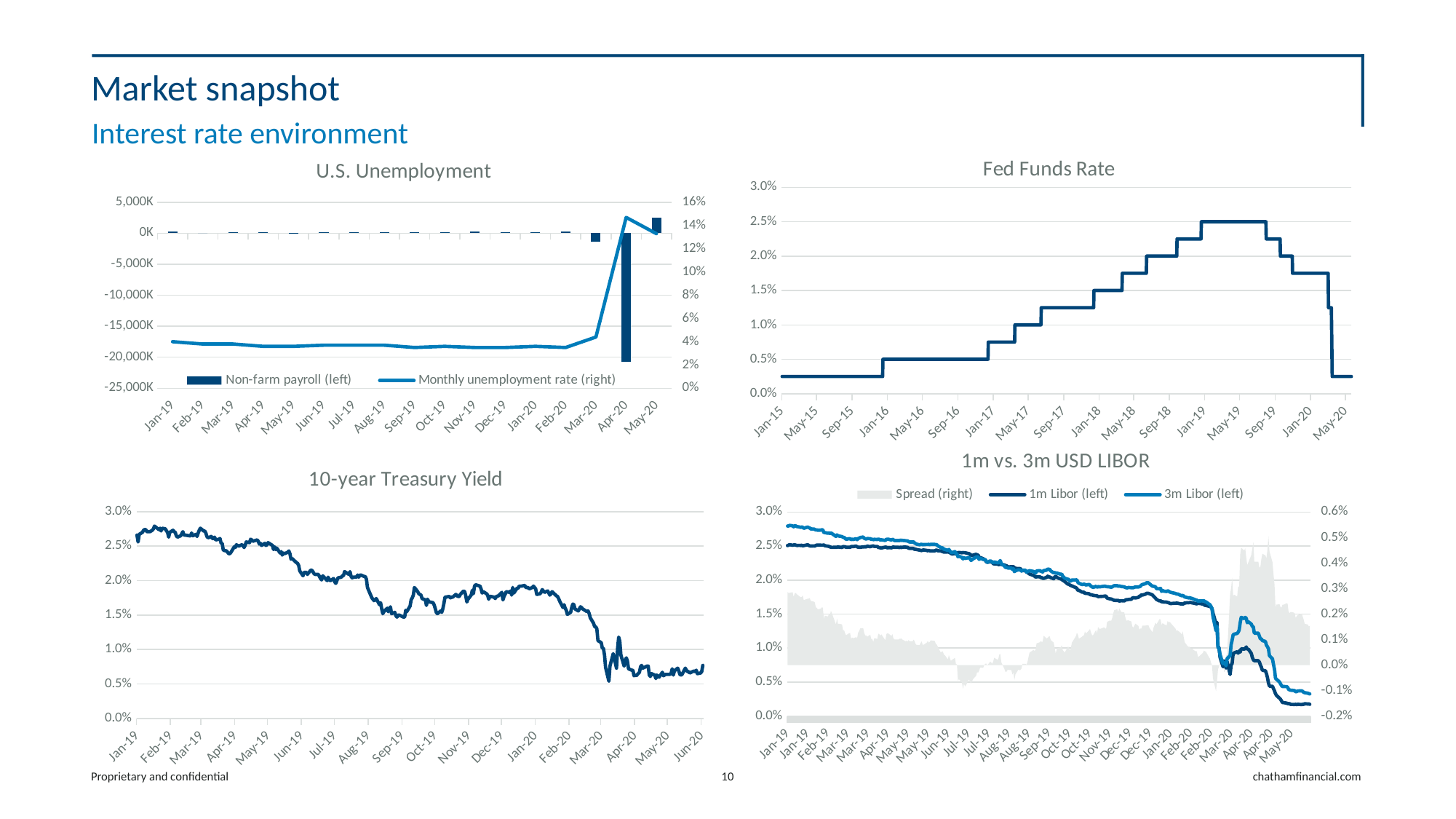
In the Fed Funds Rate chart, does the rate rise or fall from Jan-15 to May-19? rises In the U.S. Unemployment chart, is the monthly unemployment rate for Apr-20 greater or less than 12%? greater In the 10-year Treasury Yield chart, does the yield rise or fall overall from Jan-19 to Jun-20? falls In the Fed Funds Rate chart, is the value at May-20 greater or less than 0.5%? less In the 1m vs. 3m USD LIBOR chart, how many series does the legend list? 3 In the Fed Funds Rate chart, is the value at May-19 greater or less than 2.0%? greater In the U.S. Unemployment chart, how many series does the legend list? 2 In the 1m vs. 3m USD LIBOR chart, which series is plotted on the right axis? Spread In the U.S. Unemployment chart, which month has the lowest non-farm payroll bar? Apr-20 What kind of chart is the Fed Funds Rate chart? line chart